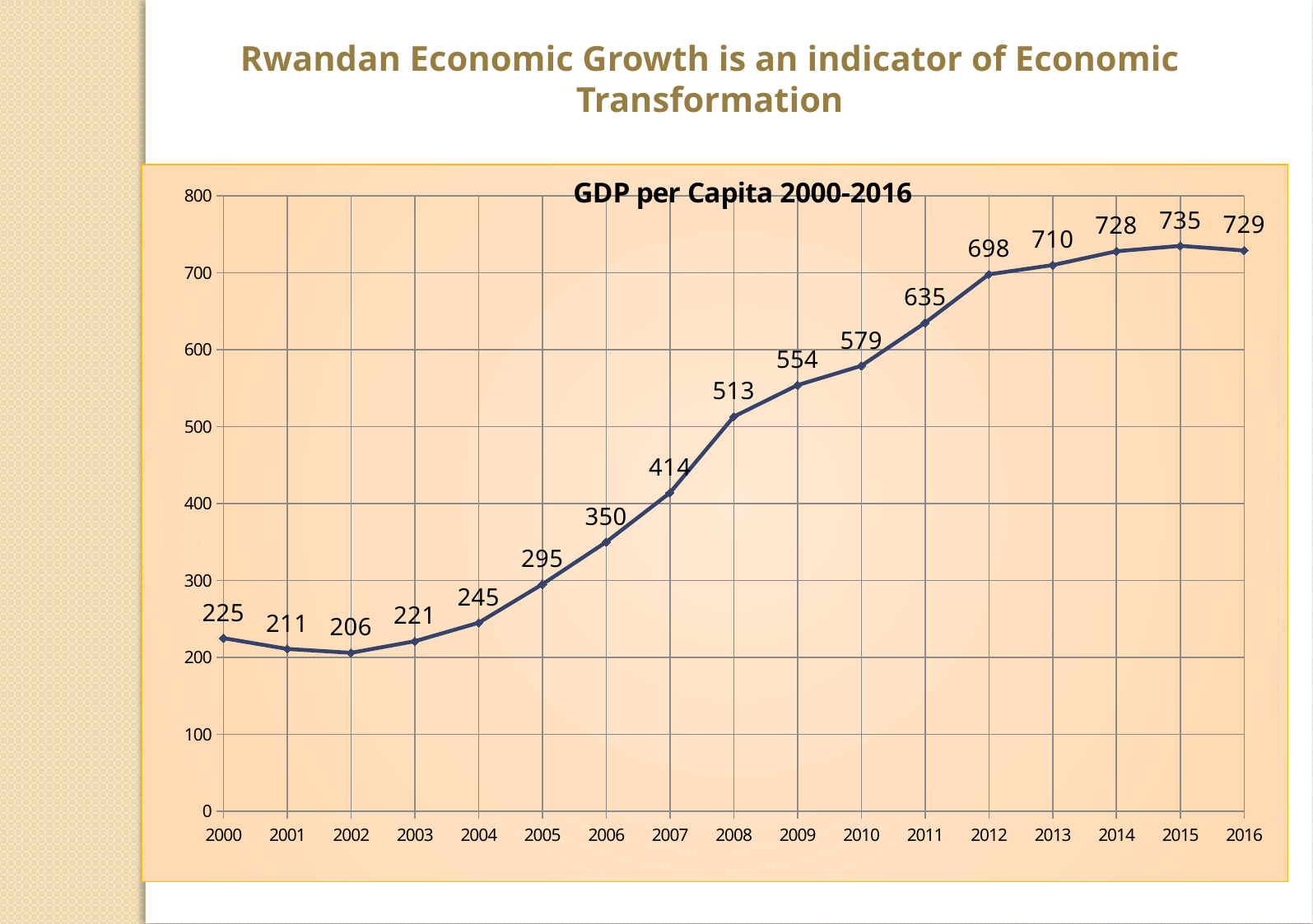
Is the GDP per capita value for 2010 greater or less than 500? greater Which year has the lowest GDP per capita? 2002 What is the title of the chart? GDP per Capita 2000-2016 Which year has the highest GDP per capita? 2015 Which is larger, the GDP per capita in 2007 or in 2009? 2009 What is the GDP per capita value for 2002? 206 What is the difference between the GDP per capita in 2012 and in 2011? 63 What is the difference between the GDP per capita in 2016 and in 2000? 504 What is the GDP per capita value for 2016? 729 What kind of chart is shown on the slide? Line chart What is the GDP per capita value for 2008? 513 How many years are plotted on the chart? 17